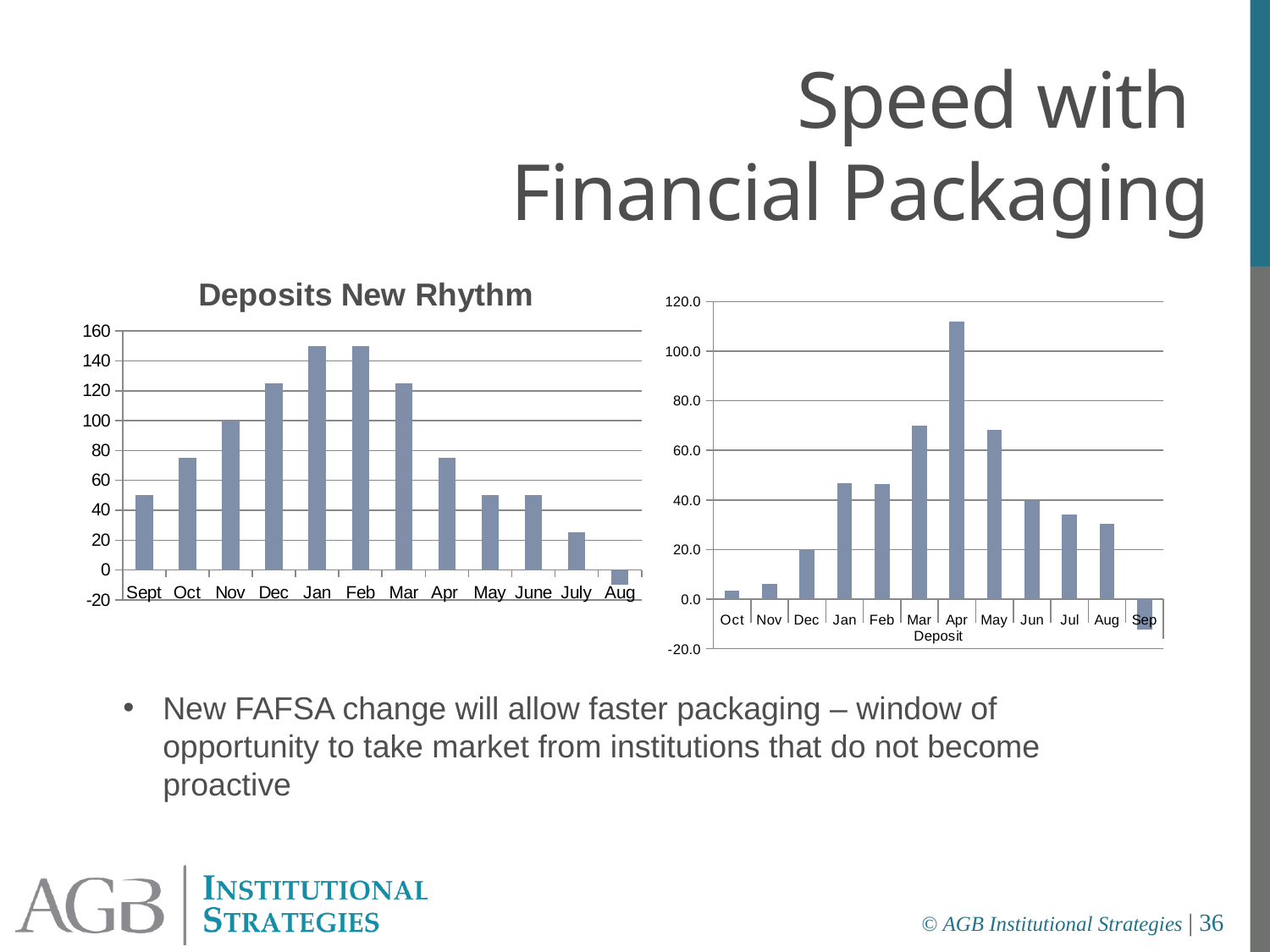
In the 'Deposits New Rhythm' chart on the left, is the value for July greater or less than 40? less In the 'Deposits New Rhythm' chart on the left, which is larger, the value for Dec or the value for Apr? Dec In the chart on the right with the 'Deposit' x-axis label, which month has the highest value? Apr How many months are shown on the x axis of the 'Deposits New Rhythm' chart on the left? 12 In the 'Deposits New Rhythm' chart on the left, which month has the lowest value? Aug In the 'Deposits New Rhythm' chart on the left, is the value for Jan greater or less than 140? greater In the chart on the right with the 'Deposit' x-axis label, which month has the lowest value? Sep In the chart on the right with the 'Deposit' x-axis label, which is larger, the value for Mar or the value for Jul? Mar In the 'Deposits New Rhythm' chart on the left, what is the value for Nov? 100 In the chart on the right with the 'Deposit' x-axis label, what is the value for Dec? 20.0 In the chart on the right with the 'Deposit' x-axis label, is the value for Apr greater or less than 100.0? greater What type of chart is the 'Deposits New Rhythm' chart on the left? bar chart